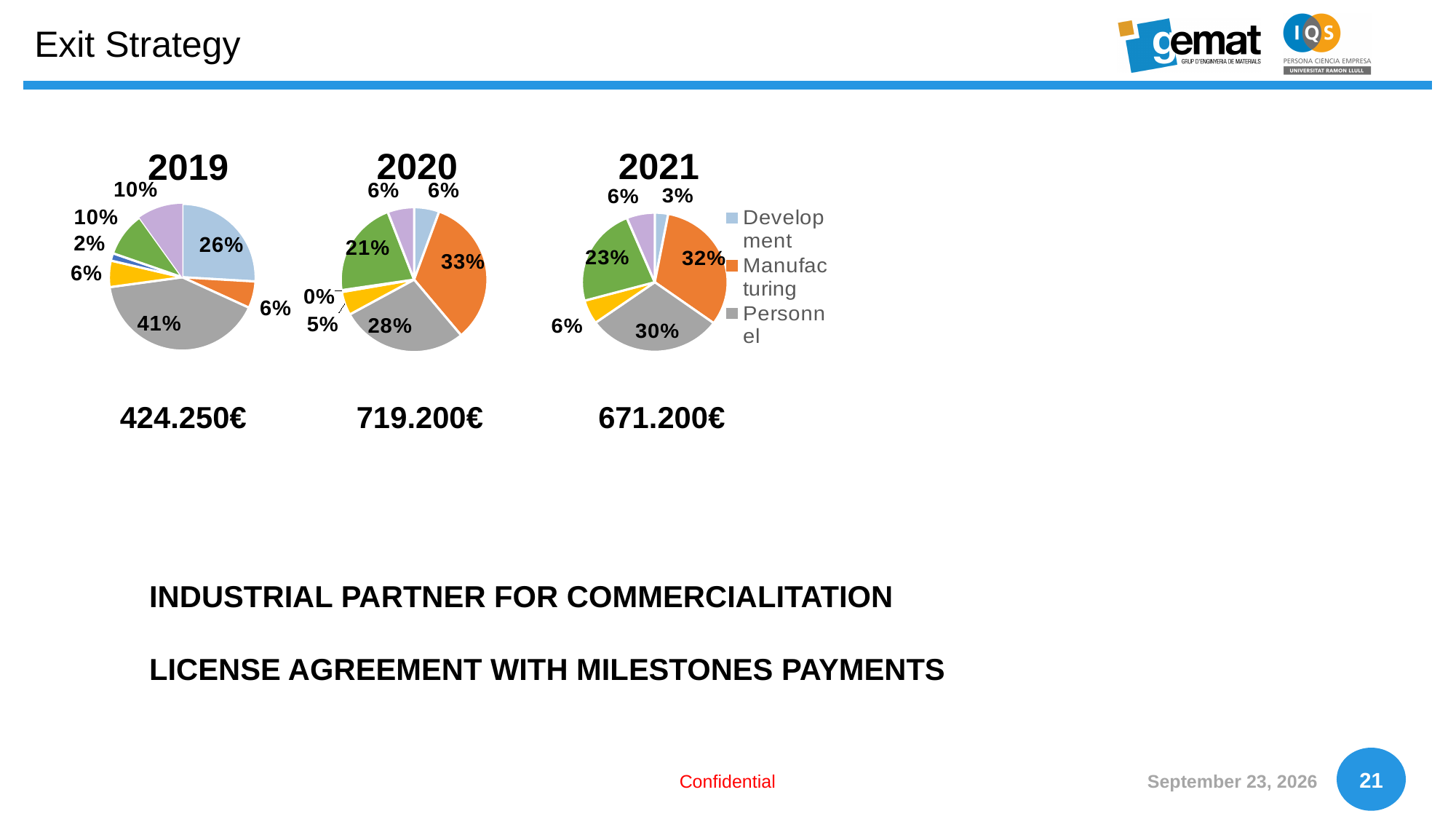
In the 2019 pie chart, what share does Development have? 26% In the 2019 pie chart, what share does Personnel have? 41% In the 2020 pie chart, what share does Manufacturing have? 33% How many categories does the legend list? 3 In the 2020 pie chart, which is larger: Manufacturing or Personnel? Manufacturing In the 2021 pie chart, which of the legend categories has the largest slice? Manufacturing In the 2019 pie chart, which of the legend categories has the smallest slice? Manufacturing What kind of charts are shown on the slide? Pie charts What total amount is shown below the 2020 pie chart? 719.200€ In the 2021 pie chart, what share does Development have? 3% In the 2021 pie chart, what is the difference in percentage points between Manufacturing and Personnel? 2 In the 2019 pie chart, what is the difference in percentage points between Personnel and Development? 15